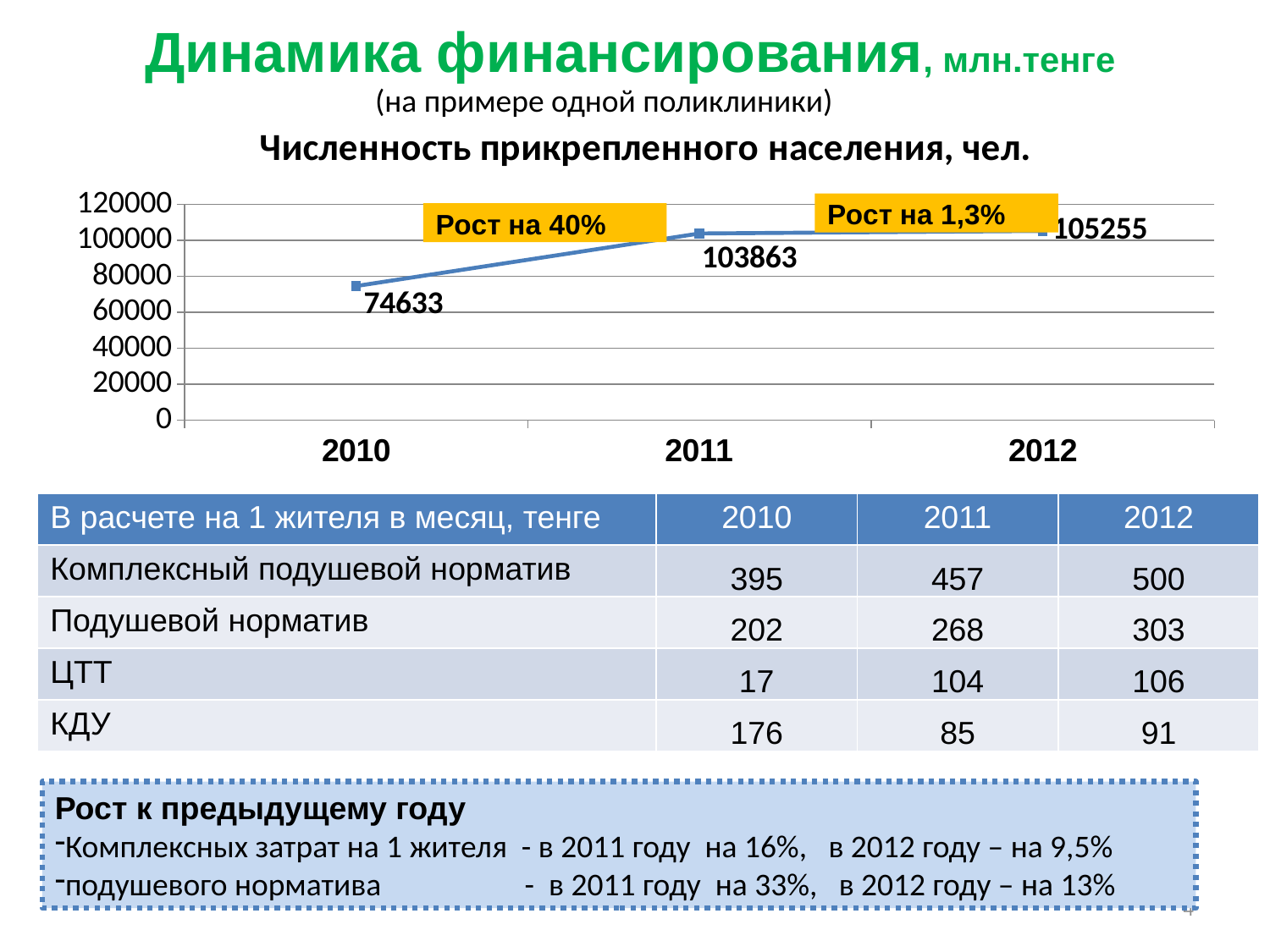
What kind of chart is shown on the slide? line chart Which year has the lowest value in the chart? 2010 Which year has the highest value in the chart? 2012 What is the value for 2010 in the chart? 74633 What is the value for 2011 in the chart? 103863 Do the values rise or fall from 2010 to 2012? rise Which is larger, the value for 2010 or the value for 2011? 2011 Is the value for 2010 greater or less than 80000? less What is the difference between the values for 2012 and 2011? 1392 What is the difference between the values for 2011 and 2010? 29230 How many years are plotted in the chart? 3 What is the value for 2012 in the chart? 105255